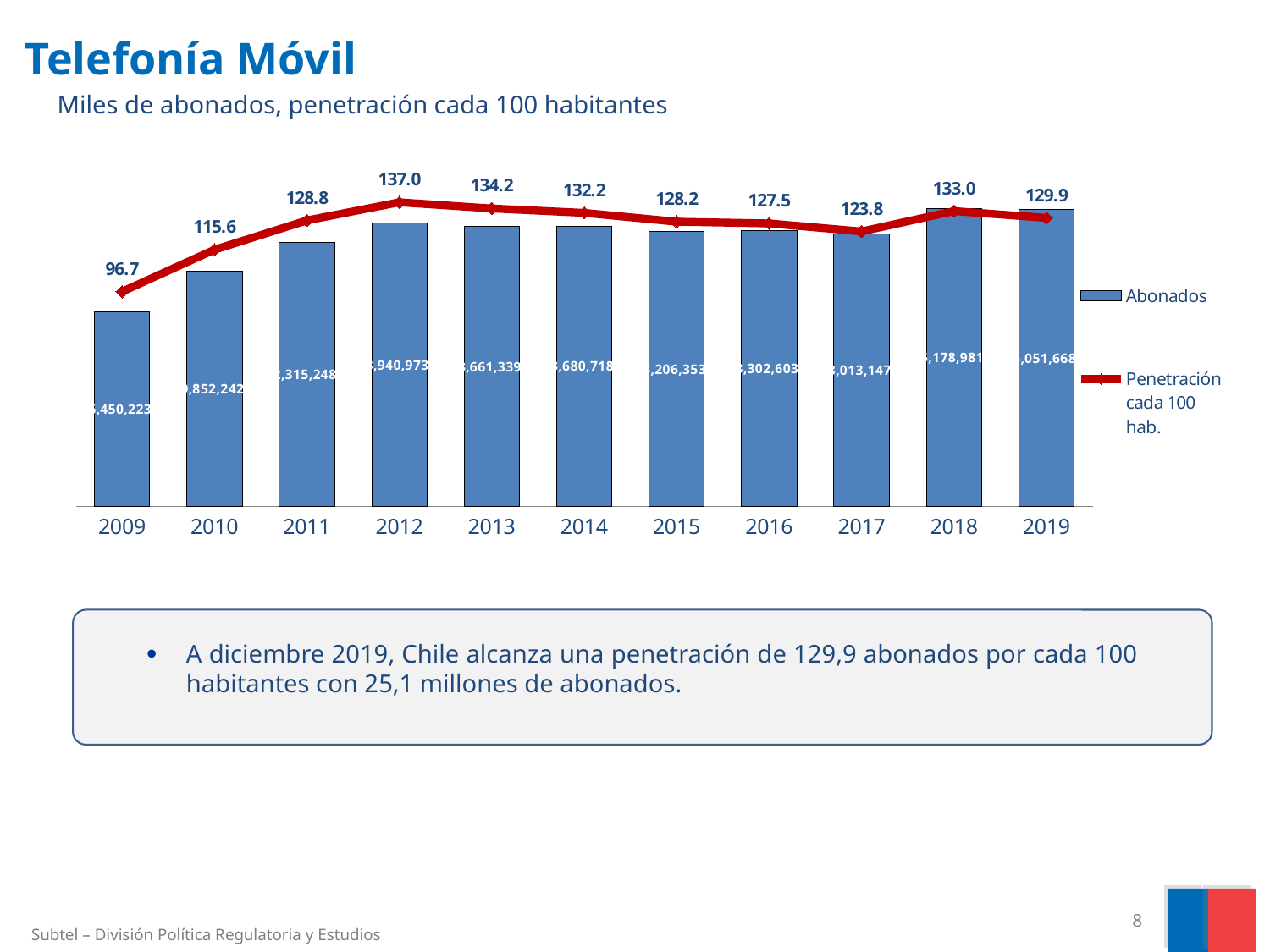
What is the penetración cada 100 hab. value for 2009? 96.7 How many series does the legend list? 2 Which year has the higher penetración cada 100 hab., 2018 or 2019? 2018 Does the penetración cada 100 hab. rise or fall from 2009 to 2012? Rise What is the penetración cada 100 hab. value for 2012? 137.0 In which year is the penetración cada 100 hab. highest? 2012 In which year is the penetración cada 100 hab. lowest? 2009 How many years are shown on the x axis of the chart? 11 What is the penetración cada 100 hab. value for 2019? 129.9 Which year has the shorter Abonados bar, 2009 or 2010? 2009 What is the difference between the penetración cada 100 hab. values for 2012 and 2017? 13.2 What kind of chart is shown on the slide? Combined bar and line chart